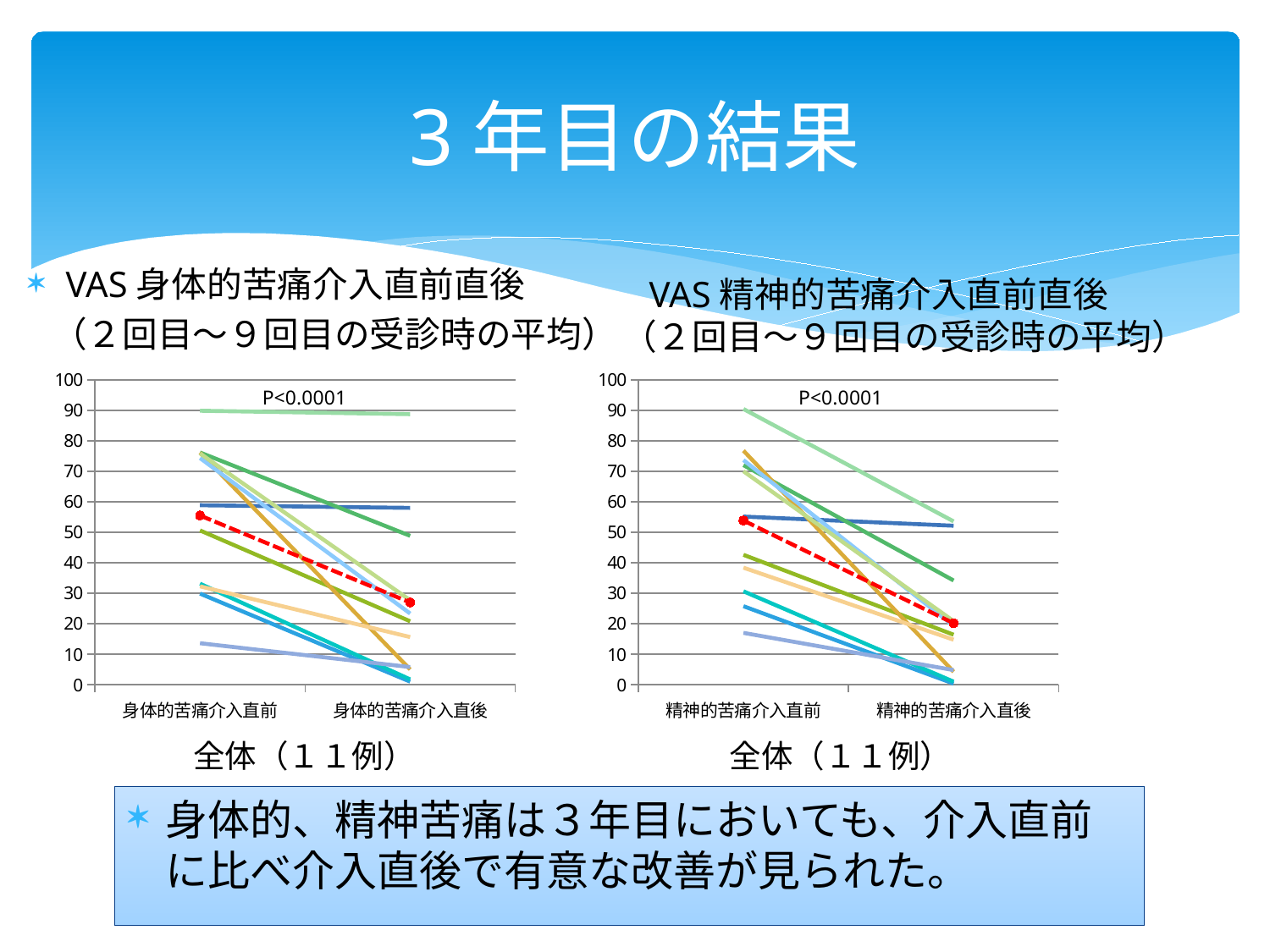
What P value is printed on the left chart (VAS 身体的苦痛介入直前直後)? P<0.0001 What kind of chart is the right chart (VAS 精神的苦痛介入直前直後)? line chart What is the maximum value shown on the y axis of the right chart (VAS 精神的苦痛介入直前直後)? 100 In the right chart (VAS 精神的苦痛介入直前直後), how many categories are shown on the x axis? 2 In the left chart (VAS 身体的苦痛介入直前直後), is the value of the red dashed line at 身体的苦痛介入直後 greater or less than 40? less In the left chart (VAS 身体的苦痛介入直前直後), does the red dashed line rise or fall from 身体的苦痛介入直前 to 身体的苦痛介入直後? fall In the right chart (VAS 精神的苦痛介入直前直後), is the value of the red dashed line at 精神的苦痛介入直後 greater or less than 30? less In the left chart (VAS 身体的苦痛介入直前直後), is the value of the red dashed line at 身体的苦痛介入直前 greater or less than 40? greater In the left chart (VAS 身体的苦痛介入直前直後), how many categories are shown on the x axis? 2 In the right chart (VAS 精神的苦痛介入直前直後), does the red dashed line rise or fall from 精神的苦痛介入直前 to 精神的苦痛介入直後? fall What kind of chart is the left chart (VAS 身体的苦痛介入直前直後)? line chart